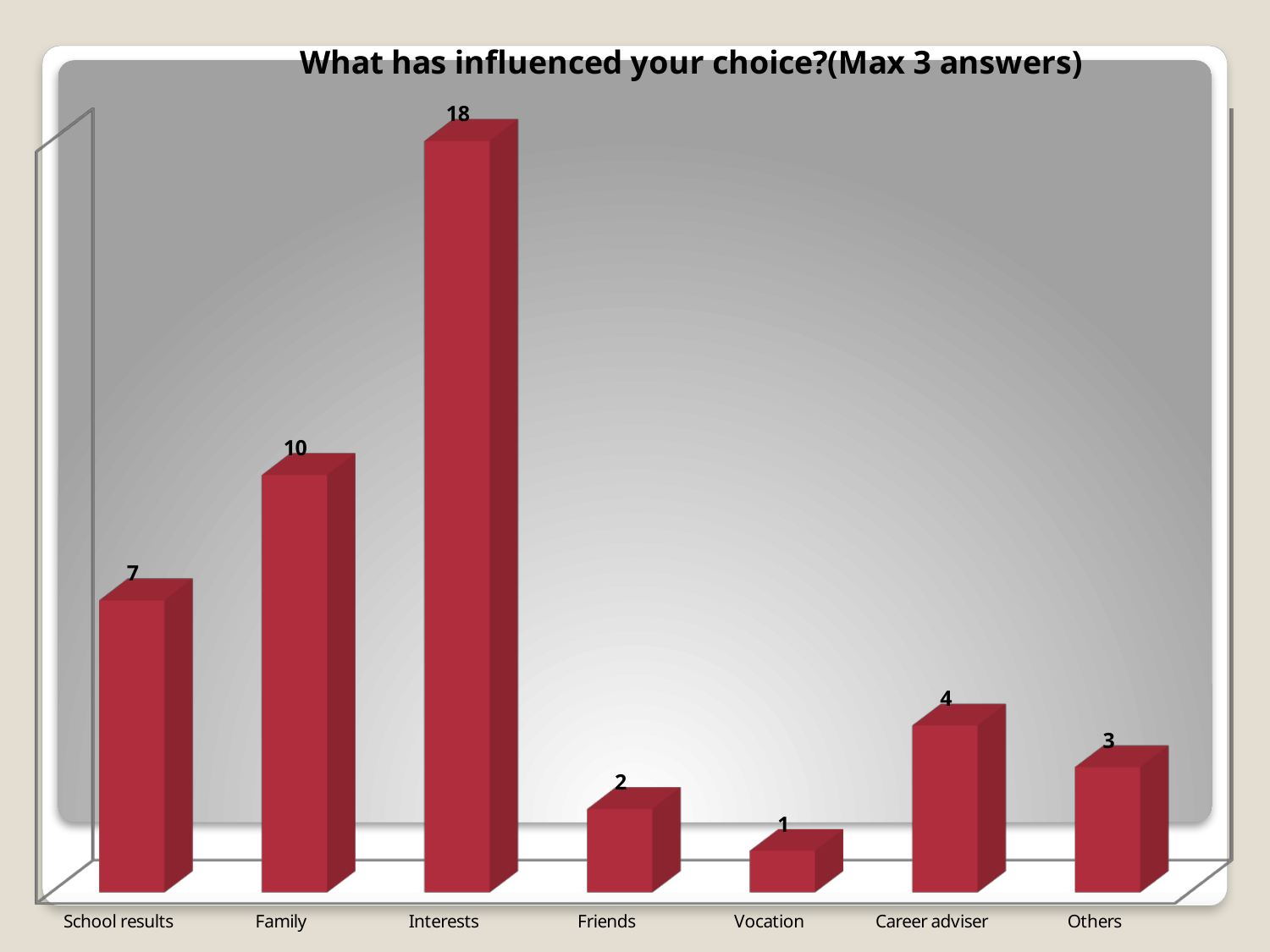
Which category has the lowest value? Vocation How many categories are shown on the x axis? 7 What is the value for Interests? 18 What is the difference between the values for Interests and Family? 8 What is the value for Vocation? 1 Which category has the highest value? Interests Which is larger, the value for Friends or the value for Career adviser? Career adviser What is the value for Career adviser? 4 What kind of chart is shown on the slide? Bar chart What is the difference between the values for School results and Others? 4 What is the title of the chart? What has influenced your choice?(Max 3 answers) What is the value for Family? 10